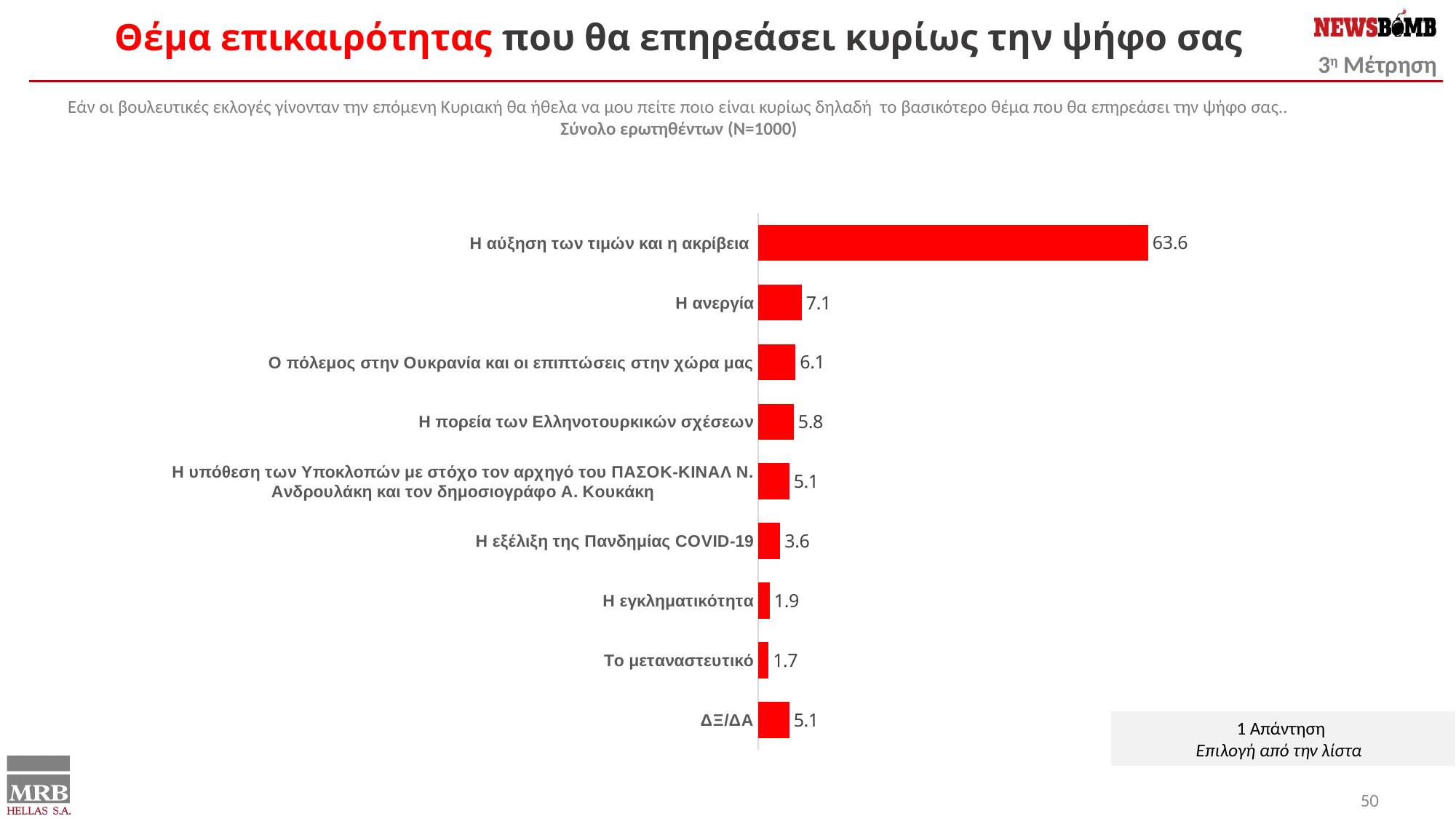
What is the difference between the values for Η εγκληματικότητα and Το μεταναστευτικό? 0.2 What is the value for Η πορεία των Ελληνοτουρκικών σχέσεων? 5.8 How many categories are shown in the chart? 9 What kind of chart is shown on the slide? Bar chart Which category has the lowest value? Το μεταναστευτικό Which category has the highest value? Η αύξηση των τιμών και η ακρίβεια What is the difference between the values for Η αύξηση των τιμών και η ακρίβεια and Η ανεργία? 56.5 What is the value for Η αύξηση των τιμών και η ακρίβεια? 63.6 What is the value for Η ανεργία? 7.1 Which is larger, the value for Η ανεργία or the value for Ο πόλεμος στην Ουκρανία και οι επιπτώσεις στην χώρα μας? Η ανεργία What is the value for ΔΞ/ΔΑ? 5.1 What is the value for Η εξέλιξη της Πανδημίας COVID-19? 3.6